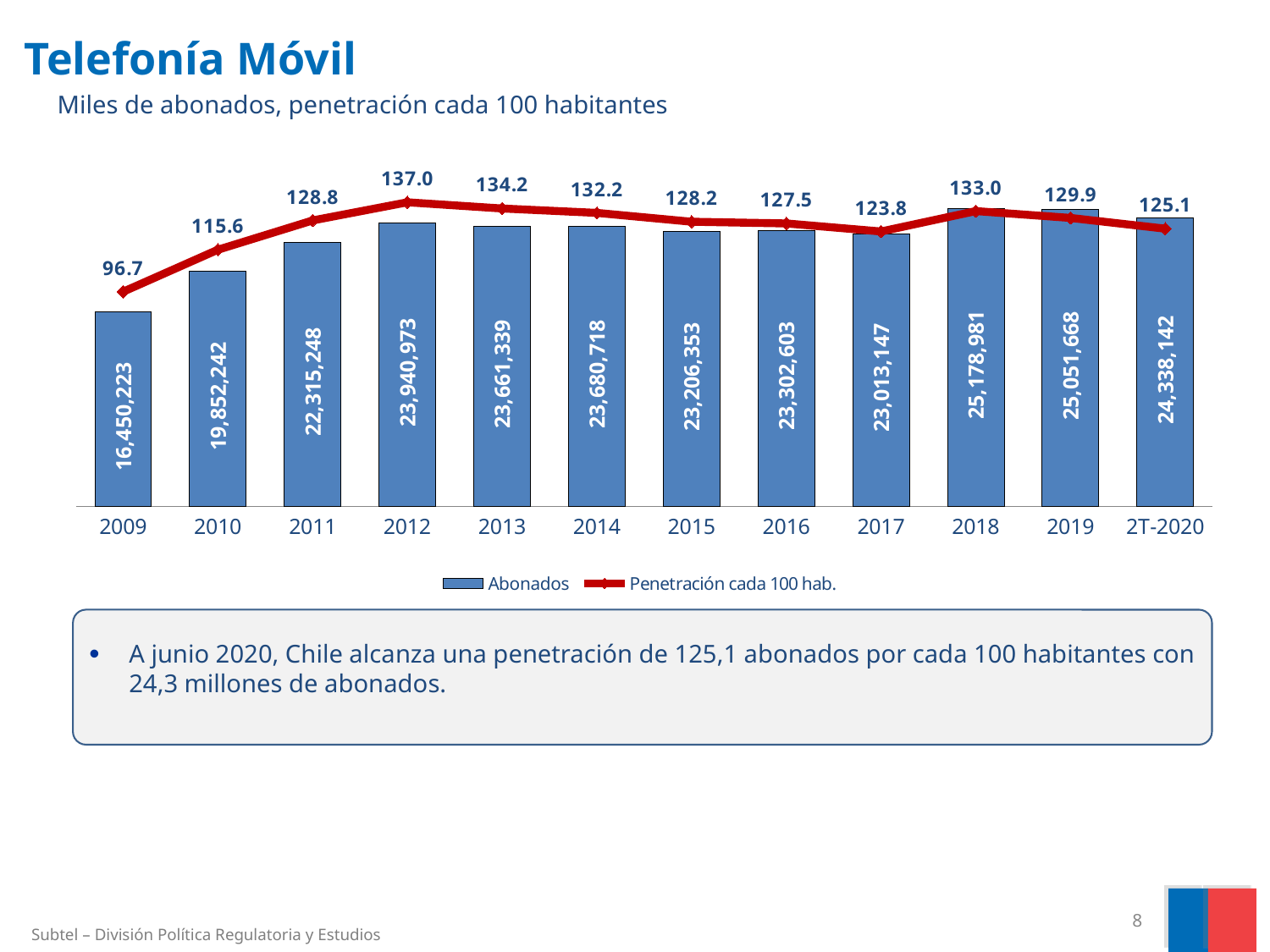
What is the difference in Abonados between 2018 and 2019? 127,313 What kind of chart is shown on the slide? Combined bar and line chart Which year has the lowest Penetración cada 100 hab. value? 2009 What is the Penetración cada 100 hab. value for 2017? 123.8 What is the Abonados value for 2T-2020? 24,338,142 How many series does the legend list? 2 How many periods are shown on the x axis? 12 In which year does Penetración cada 100 hab. reach its highest value? 2012 Which year has the highest Abonados value? 2018 Which is larger, the Abonados value for 2010 or for 2011? 2011 What is the value of Abonados for 2012? 23,940,973 By how much does Penetración cada 100 hab. in 2012 exceed that of 2T-2020? 11.9